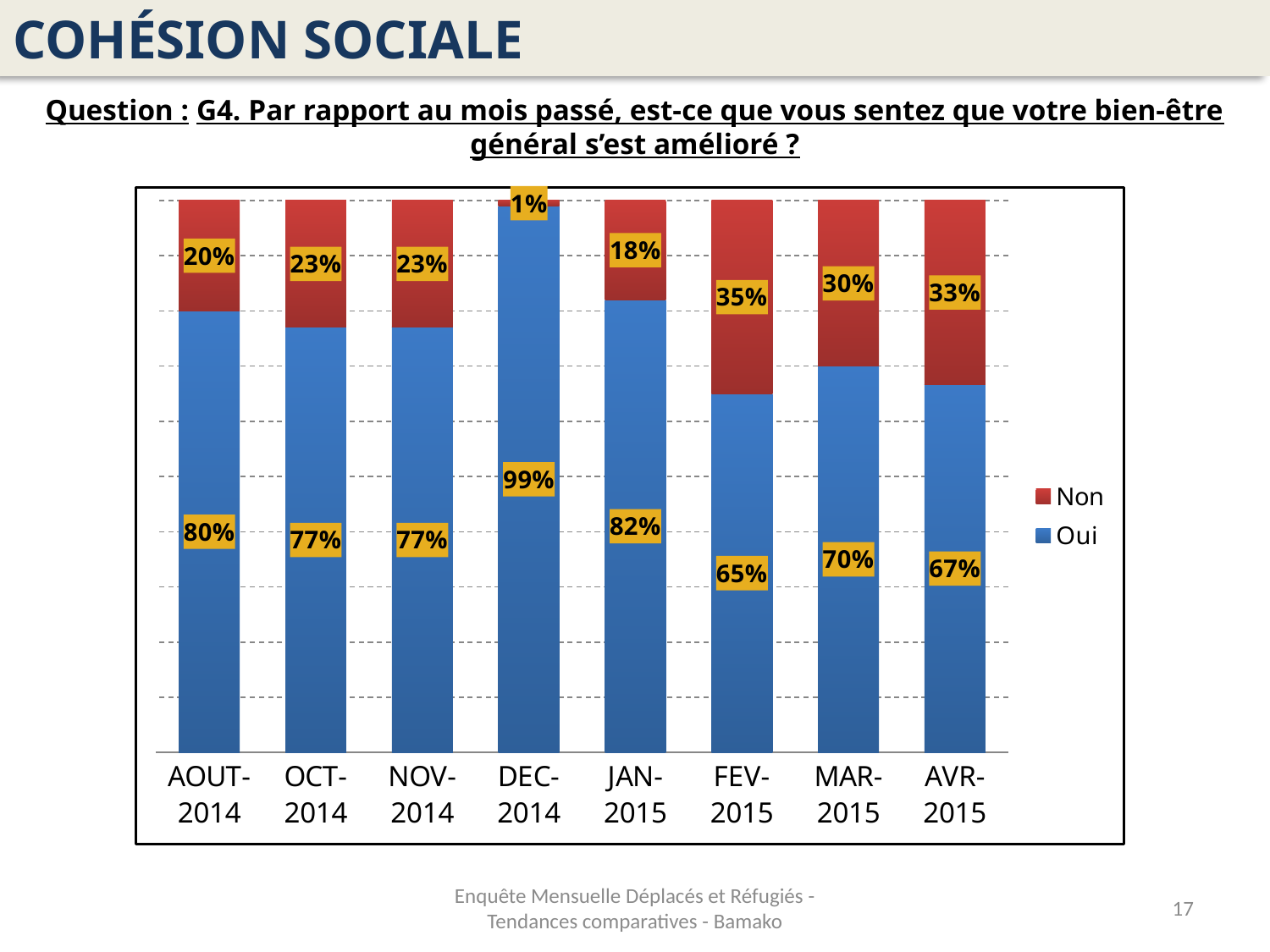
What is the value for Non in FEV-2015? 35% How many months are shown on the x axis? 8 Which colour represents Non in the legend? Red Which month has the highest value for Oui? DEC-2014 What kind of chart is shown on the slide? Stacked bar chart Which month has the lowest value for Oui? FEV-2015 What is the value for Oui in DEC-2014? 99% How many series does the legend list? 2 Which is larger, the Non value for MAR-2015 or the Non value for JAN-2015? MAR-2015 What is the value for Oui in AVR-2015? 67% What is the difference between the Oui values for AOUT-2014 and FEV-2015? 15% Which month has the highest value for Non? FEV-2015